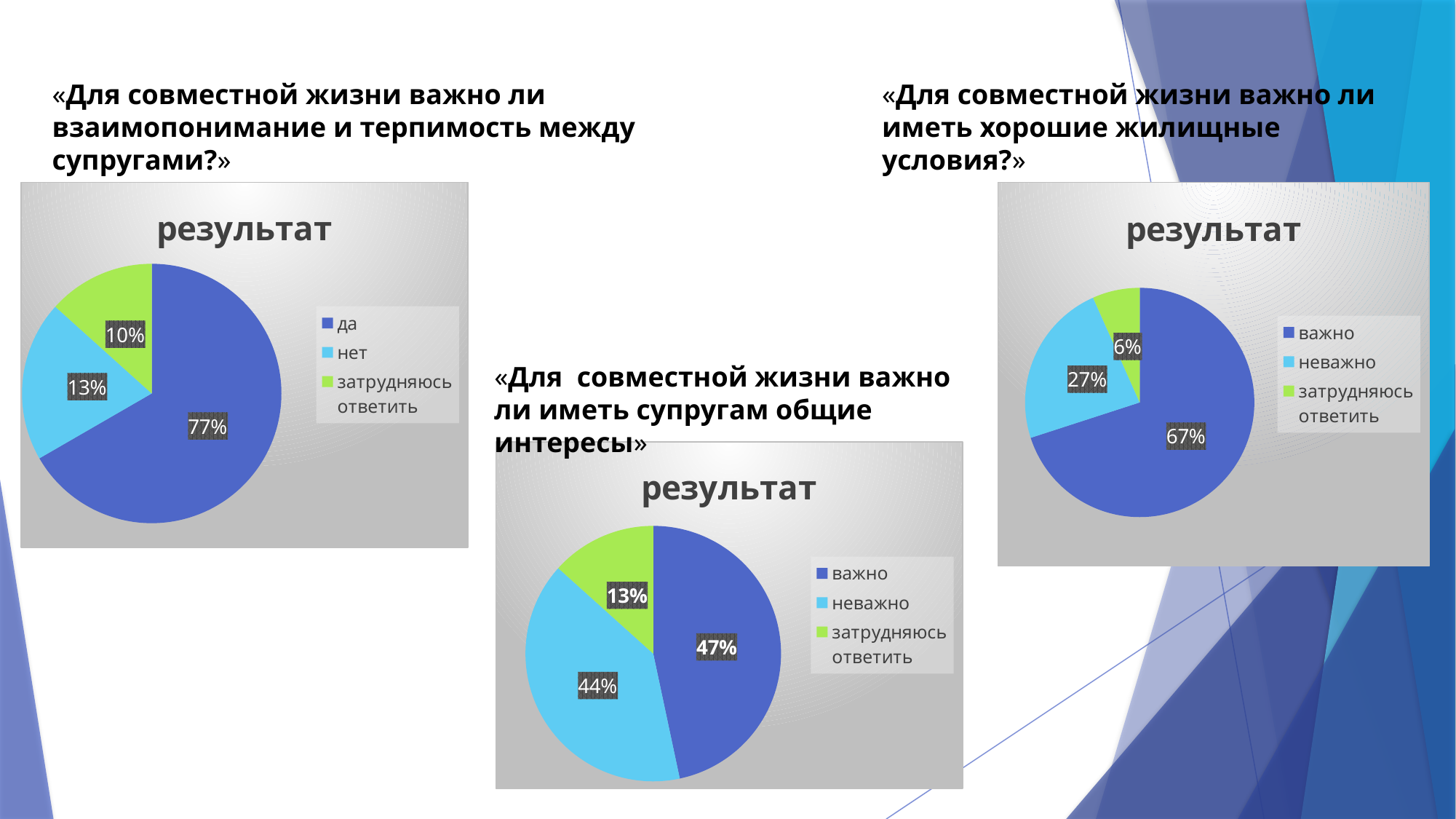
In the middle (bottom) pie chart about shared interests, what share answered «важно»? 47% How many charts are on the slide, and what type are they? Three pie charts In the left pie chart, what share answered «нет»? 13% In the middle (bottom) pie chart, what share answered «неважно»? 44% In the left pie chart (about mutual understanding and tolerance between spouses), what share answered «да»? 77% In the left pie chart, what is the difference between the «да» and «нет» shares? 64 percentage points In the middle (bottom) pie chart, what share answered «затрудняюсь ответить»? 13% In the right pie chart about housing conditions, what share answered «важно»? 67% In the left pie chart, which answer has the smallest share? затрудняюсь ответить In the right pie chart, what is the difference between the «важно» and «неважно» shares? 40 percentage points In the right pie chart, what share answered «затрудняюсь ответить»? 6% In the right pie chart, which answer has the largest share? важно